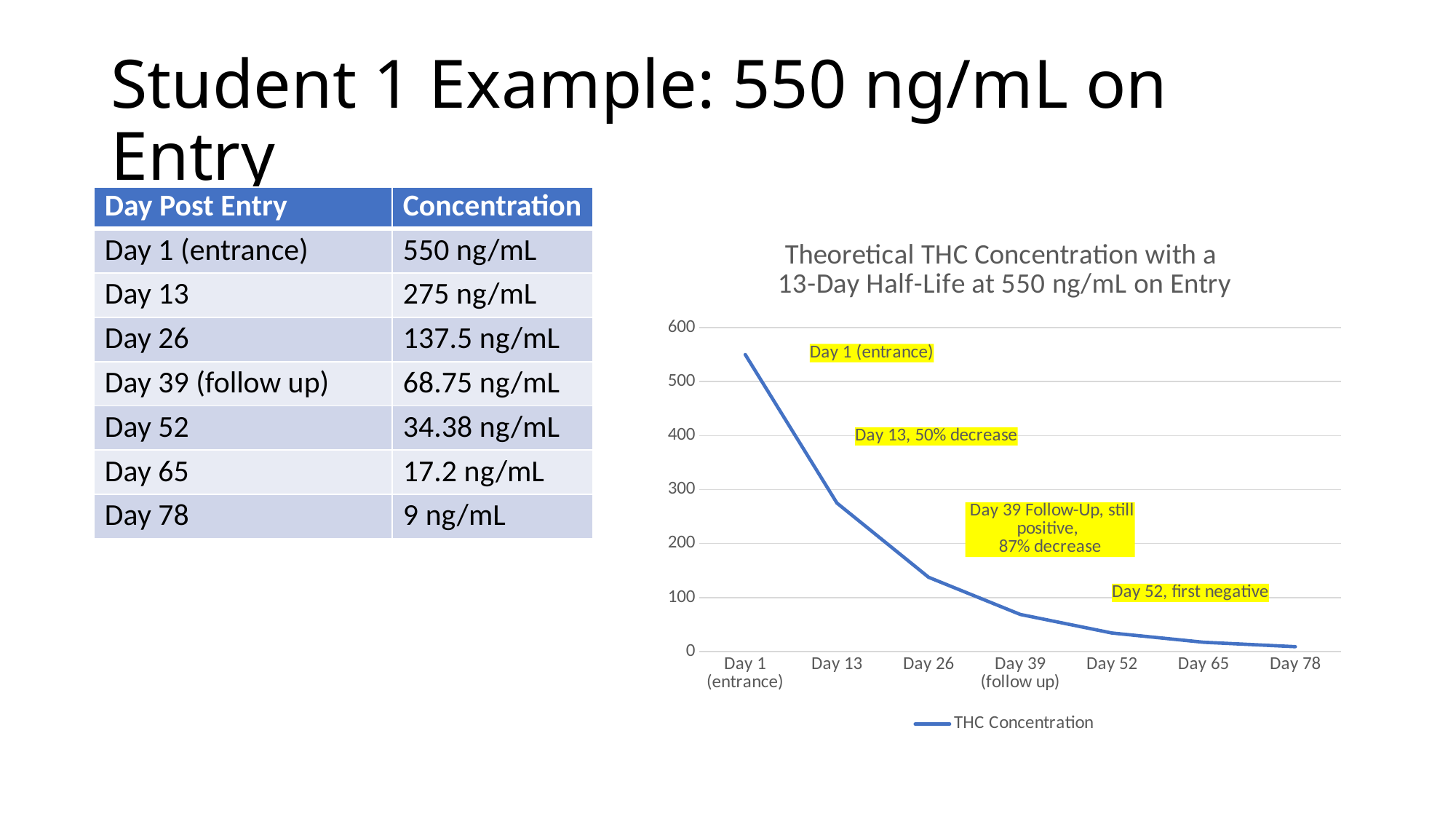
Is the THC concentration at Day 1 (entrance) greater or less than 500? greater What is the title of the chart? Theoretical THC Concentration with a 13-Day Half-Life at 550 ng/mL on Entry Using the values in the table, what is the difference between the concentration at Day 1 (entrance) and at Day 13? 275 ng/mL How many data points are plotted along the x axis of the chart? 7 Which day has the highest THC concentration in the chart? Day 1 (entrance) What type of chart is shown on the slide? line chart Do the THC concentration values rise or fall from Day 1 to Day 78 along the x axis? fall How many series does the chart legend list? 1 What is the name of the series in the chart legend? THC Concentration According to the table on the slide, what is the concentration at Day 39 (follow up)? 68.75 ng/mL Which day has the lowest THC concentration in the chart? Day 78 Is the THC concentration at Day 13 greater or less than 300? less